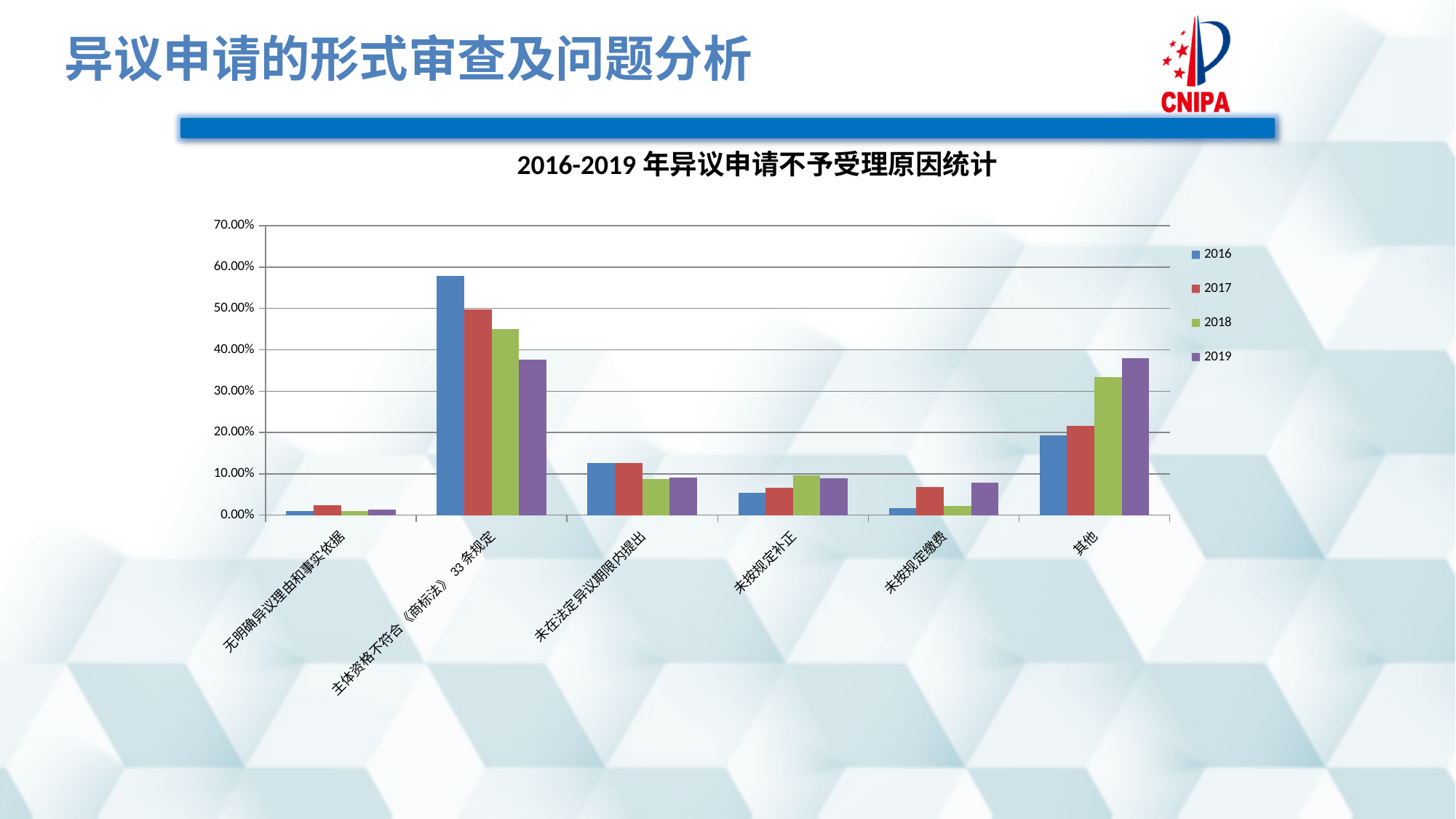
For 主体资格不符合《商标法》33条规定, do the values rise or fall from 2016 to 2019? fall What kind of chart is shown on the slide? bar chart How many series does the chart's legend list? 4 Is the 2016 value for 主体资格不符合《商标法》33条规定 greater or less than 50.00%? greater Is the 2019 value for 其他 greater or less than 30.00%? greater What is the title of the chart? 2016-2019 年异议申请不予受理原因统计 For 其他, do the values rise or fall from 2016 to 2019? rise How many categories are shown on the x axis of the chart? 6 For 未按规定缴费, which is larger: the 2017 value or the 2018 value? 2017 Is the 2016 value for 未按规定缴费 greater or less than 10.00%? less Which years are listed in the chart's legend? 2016, 2017, 2018, 2019 Which category has the highest value for 2016? 主体资格不符合《商标法》33条规定